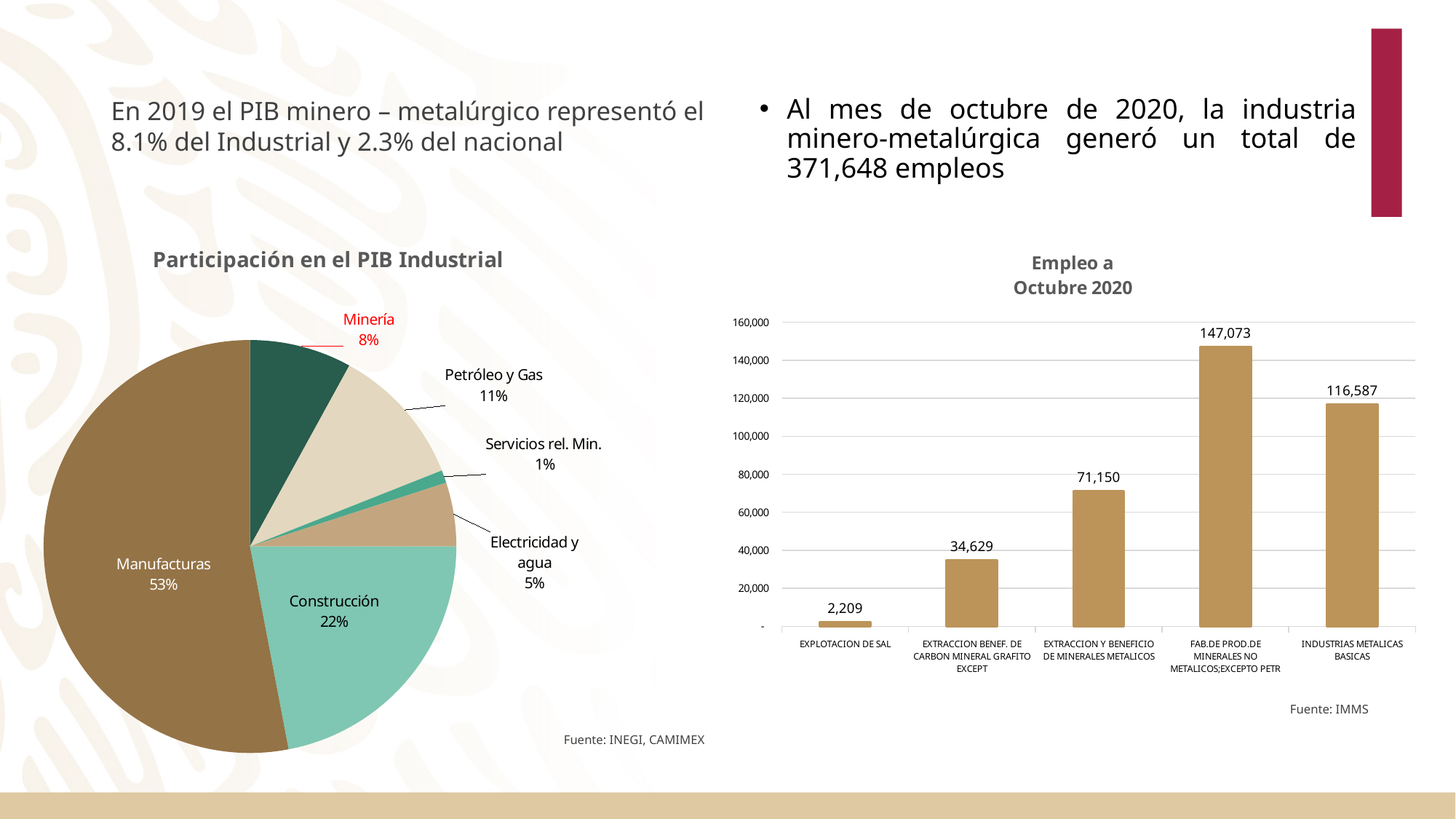
In the 'Empleo a Octubre 2020' chart, how many bars are there? 5 In the 'Participación en el PIB Industrial' chart, which category has the smallest share? Servicios rel. Min. In the 'Empleo a Octubre 2020' chart, which category has the lowest value? EXPLOTACION DE SAL In the 'Participación en el PIB Industrial' chart, which is larger, Petróleo y Gas or Electricidad y agua? Petróleo y Gas In the 'Empleo a Octubre 2020' chart, what is the value for INDUSTRIAS METALICAS BASICAS? 116,587 In the 'Participación en el PIB Industrial' chart, what share does Manufacturas have? 53% In the 'Participación en el PIB Industrial' chart, how many slices does the pie have? 6 What kind of chart is 'Empleo a Octubre 2020'? Bar chart In the 'Empleo a Octubre 2020' chart, what is the difference between FAB.DE PROD.DE MINERALES NO METALICOS;EXCEPTO PETR and INDUSTRIAS METALICAS BASICAS? 30,486 In the 'Empleo a Octubre 2020' chart, which category has the highest value? FAB.DE PROD.DE MINERALES NO METALICOS;EXCEPTO PETR What kind of chart is 'Participación en el PIB Industrial'? Pie chart In the 'Participación en el PIB Industrial' chart, what share does Minería have? 8%